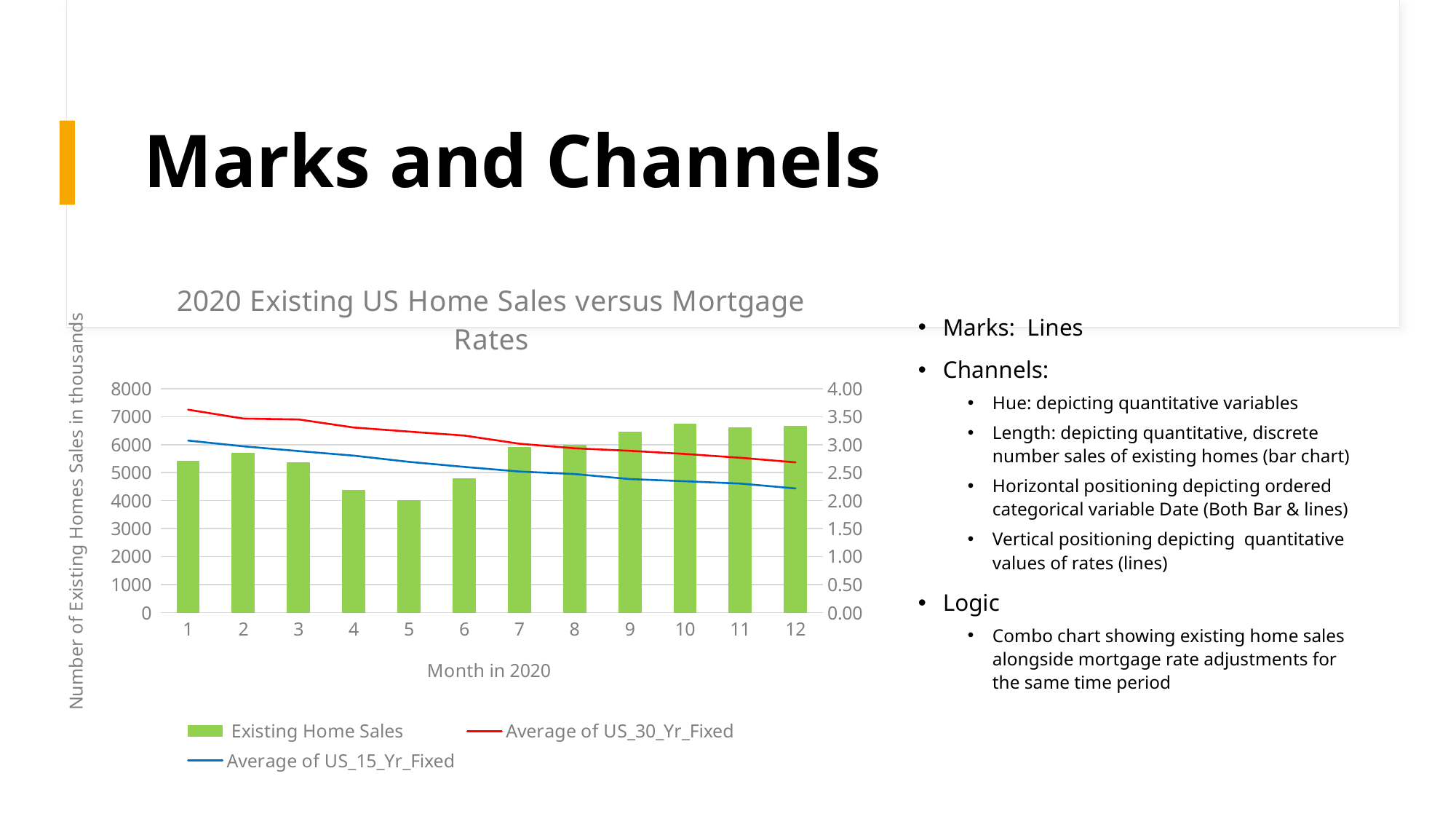
Which month has the lowest Existing Home Sales bar? 5 How many months are plotted along the x axis? 12 Does the Average of US_30_Yr_Fixed line rise or fall from month 1 to month 12? Fall What is the label of the x axis? Month in 2020 Is the Existing Home Sales value for month 5 greater or less than 5000? less Is the Average of US_15_Yr_Fixed value for month 12 greater or less than 2.50? less Which is larger, Existing Home Sales in month 5 or in month 10? Month 10 What is the title of the chart? 2020 Existing US Home Sales versus Mortgage Rates Is the Existing Home Sales value for month 10 greater or less than 6000? greater How many series does the chart legend list? 3 What kind of chart is shown on the slide? A combination bar and line chart